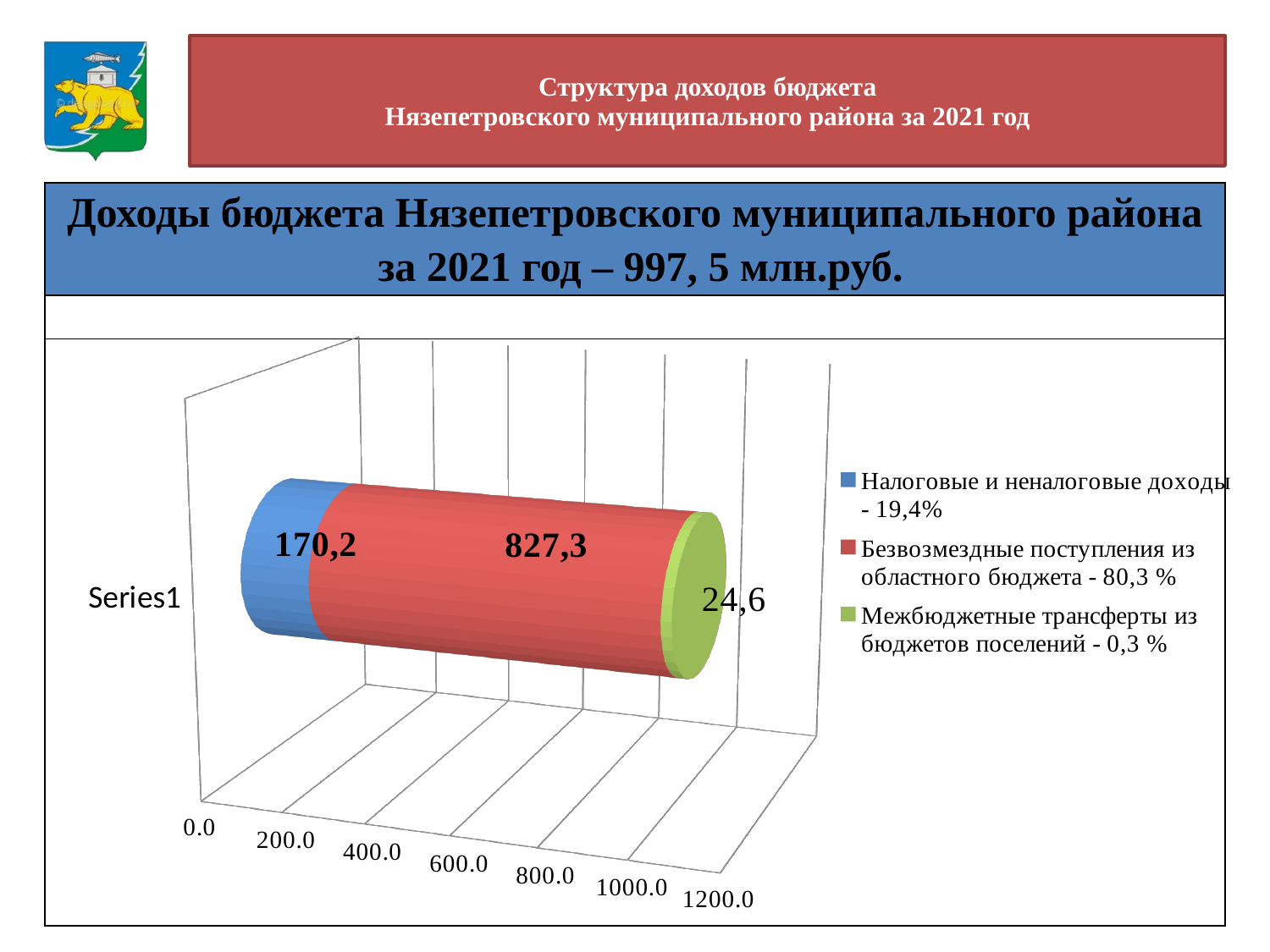
What is the difference between the value for Безвозмездные поступления из областного бюджета and the value for Налоговые и неналоговые доходы? 657,1 How many series does the legend list? 3 What is the value for Безвозмездные поступления из областного бюджета? 827,3 What is the difference between the value for Налоговые и неналоговые доходы and the value for Межбюджетные трансферты из бюджетов поселений? 145,6 Which series has the smallest value in the bar? Межбюджетные трансферты из бюджетов поселений Which series has the largest value in the bar? Безвозмездные поступления из областного бюджета What is the value for Межбюджетные трансферты из бюджетов поселений? 24,6 What kind of chart is shown on the slide? Stacked bar chart What total amount of budget revenue for 2021 is stated in the chart title? 997, 5 млн.руб. Which is larger: the value for Налоговые и неналоговые доходы or the value for Межбюджетные трансферты из бюджетов поселений? Налоговые и неналоговые доходы What is the value for Налоговые и неналоговые доходы in the stacked bar? 170,2 What percentage share does the legend give for Безвозмездные поступления из областного бюджета? 80,3 %